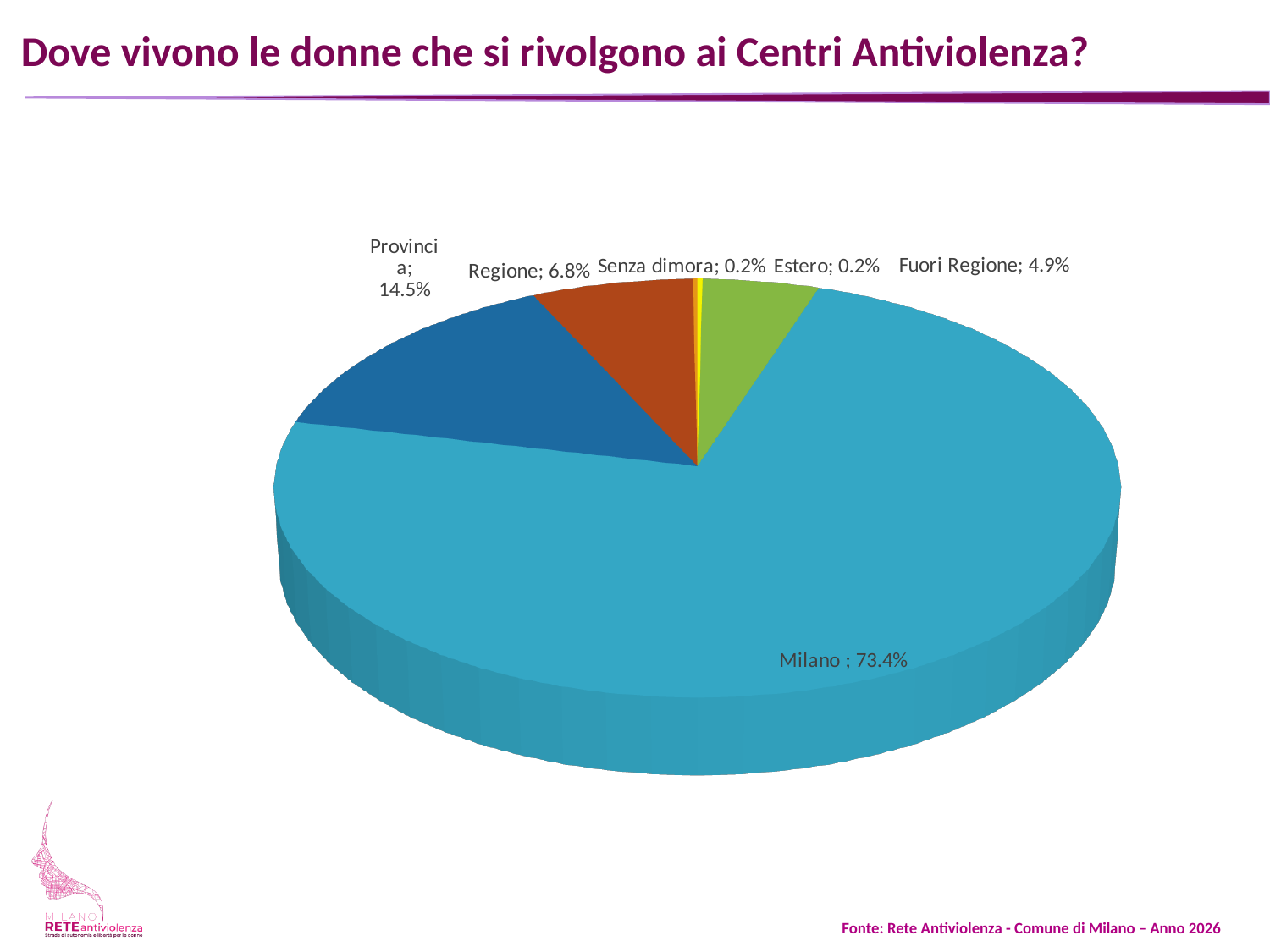
What kind of chart is shown on the slide? pie chart What is the value shown for Regione? 6.8% Which is larger, the slice for Provincia or the slice for Regione? Provincia What is the difference in percentage points between Regione and Fuori Regione? 1.9 What is the value shown for Senza dimora? 0.2% What is the difference in percentage points between Milano and Provincia? 58.9 What is the value shown for Fuori Regione? 4.9% What is the value shown for Provincia? 14.5% What share of the pie does Milano account for? 73.4% How many slices does the pie chart have? 6 Which category has the largest slice of the pie? Milano What is the title of the slide containing the chart? Dove vivono le donne che si rivolgono ai Centri Antiviolenza?